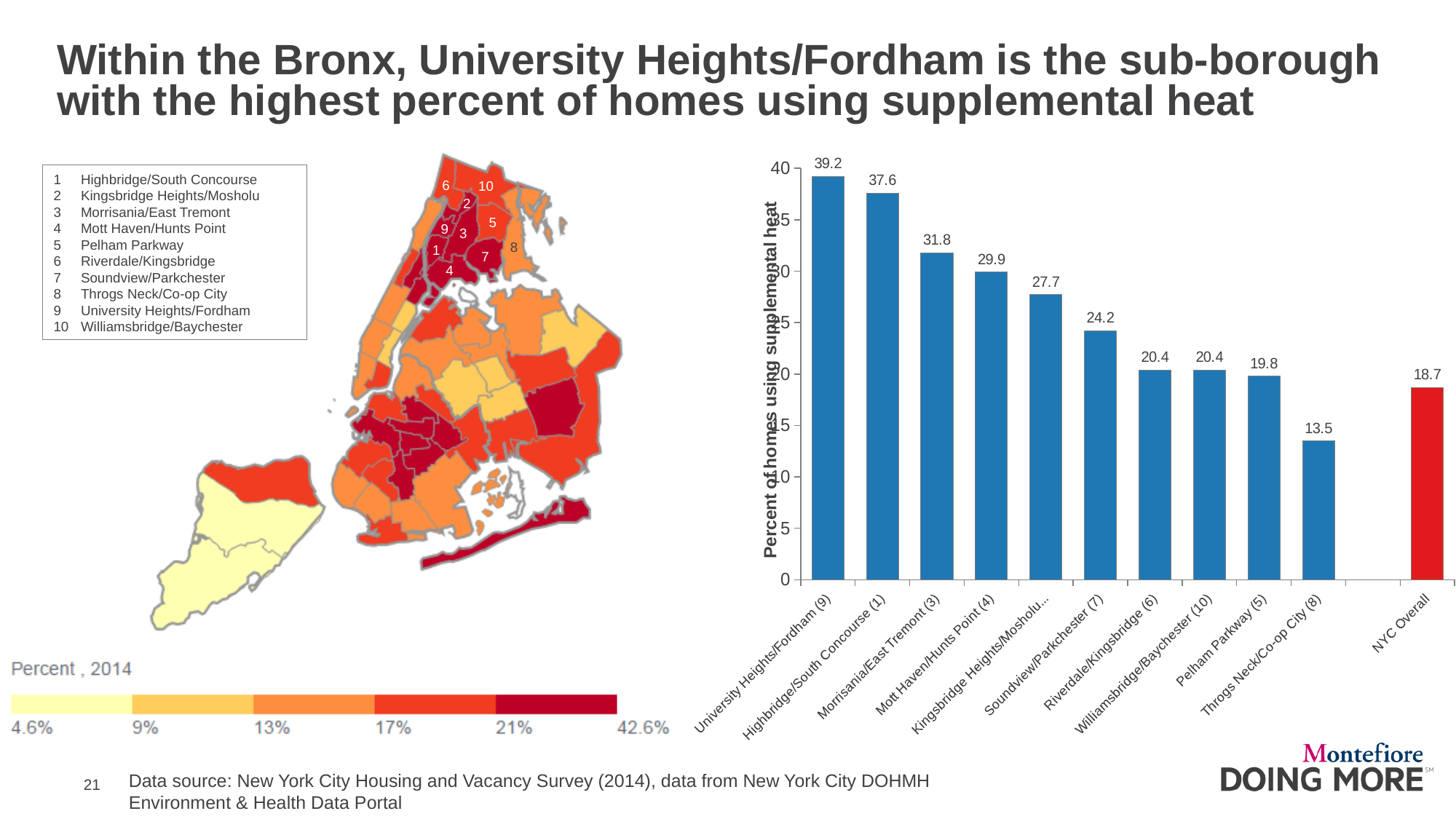
How many bars are plotted in the bar chart? 11 In the bar chart, what is the value for Throgs Neck/Co-op City (8)? 13.5 In the bar chart, what is the difference between the values for University Heights/Fordham (9) and Highbridge/South Concourse (1)? 1.6 What kind of chart is shown on the right side of the slide? Bar chart In the bar chart, which is larger: the value for Morrisania/East Tremont (3) or Mott Haven/Hunts Point (4)? Morrisania/East Tremont (3) In the bar chart, what is the difference between the values for Pelham Parkway (5) and NYC Overall? 1.1 In the bar chart, what is the value for NYC Overall? 18.7 In the bar chart, which sub-borough has the lowest percent of homes using supplemental heat? Throgs Neck/Co-op City (8) In the bar chart, what is the value for Soundview/Parkchester (7)? 24.2 In the bar chart, which bar is coloured red rather than blue? NYC Overall In the bar chart, what is the percent of homes using supplemental heat for University Heights/Fordham (9)? 39.2 In the bar chart, which sub-borough has the highest percent of homes using supplemental heat? University Heights/Fordham (9)